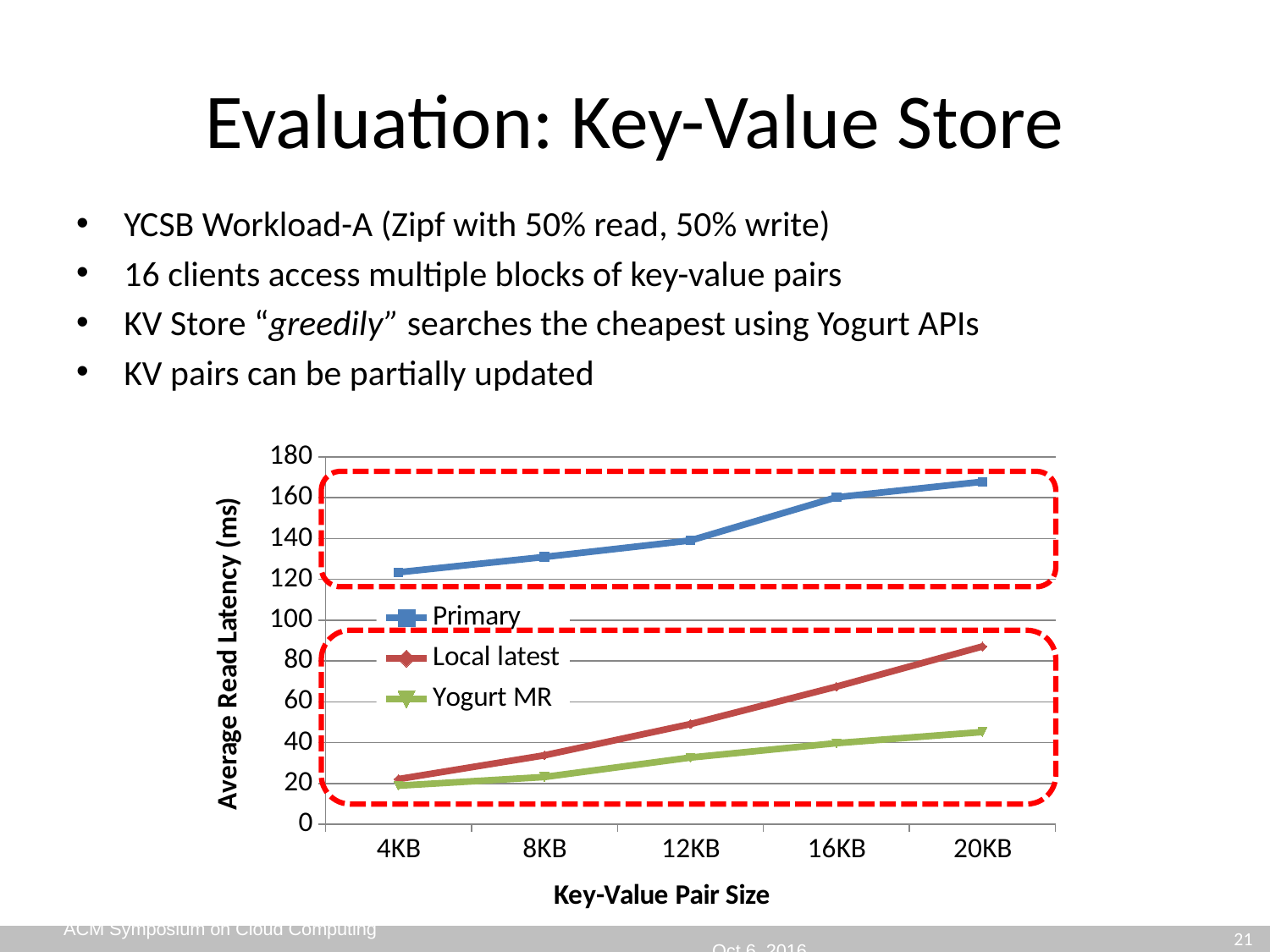
What kind of chart is shown on the slide? line chart How many series does the chart legend list? 3 Is the Primary average read latency at 4KB greater or less than 140? less Is the Primary average read latency at 20KB greater or less than 160? greater At which key-value pair size is the Yogurt MR average read latency lowest? 4KB Is the Local latest average read latency at 12KB greater or less than 40? greater Which series has the highest average read latency at 20KB? Primary How many key-value pair sizes are plotted along the x axis? 5 At 20KB, which series has the higher average read latency, Local latest or Yogurt MR? Local latest Does the Local latest average read latency rise or fall as the key-value pair size increases? rise